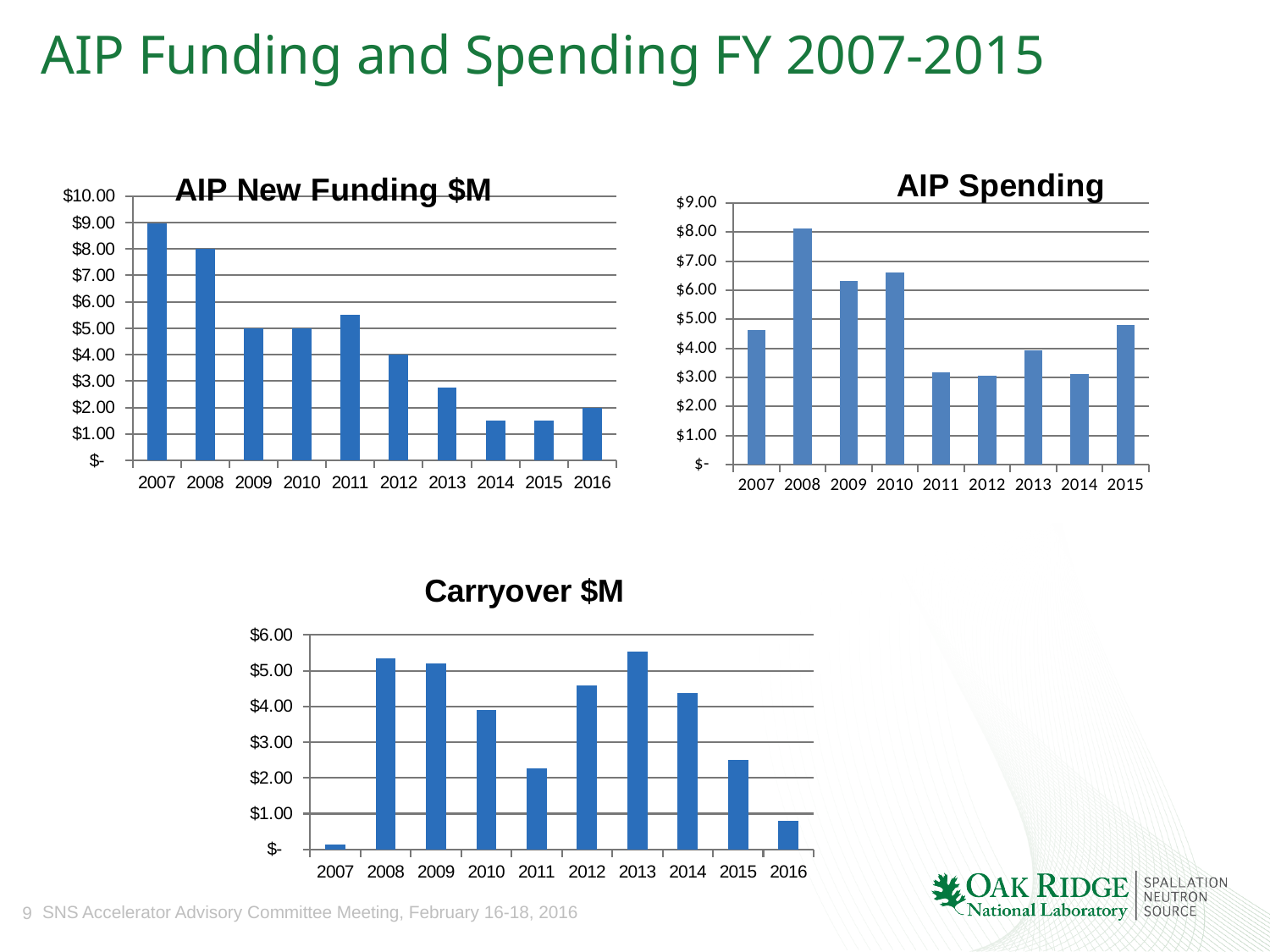
In the AIP Spending chart, how many years are shown on the x axis? 9 In the AIP New Funding $M chart, which year has the highest value? 2007 What kind of chart is the Carryover $M chart? bar chart In the AIP New Funding $M chart, how many years are shown on the x axis? 10 In the AIP New Funding $M chart, what is the value for 2012? $4.00 In the AIP Spending chart, is the value for 2011 greater or less than $4.00? less In the AIP Spending chart, which year has the highest value? 2008 In the AIP New Funding $M chart, what is the value for 2008? $8.00 In the Carryover $M chart, is the value for 2013 greater or less than $5.00? greater In the Carryover $M chart, which year has the lowest value? 2007